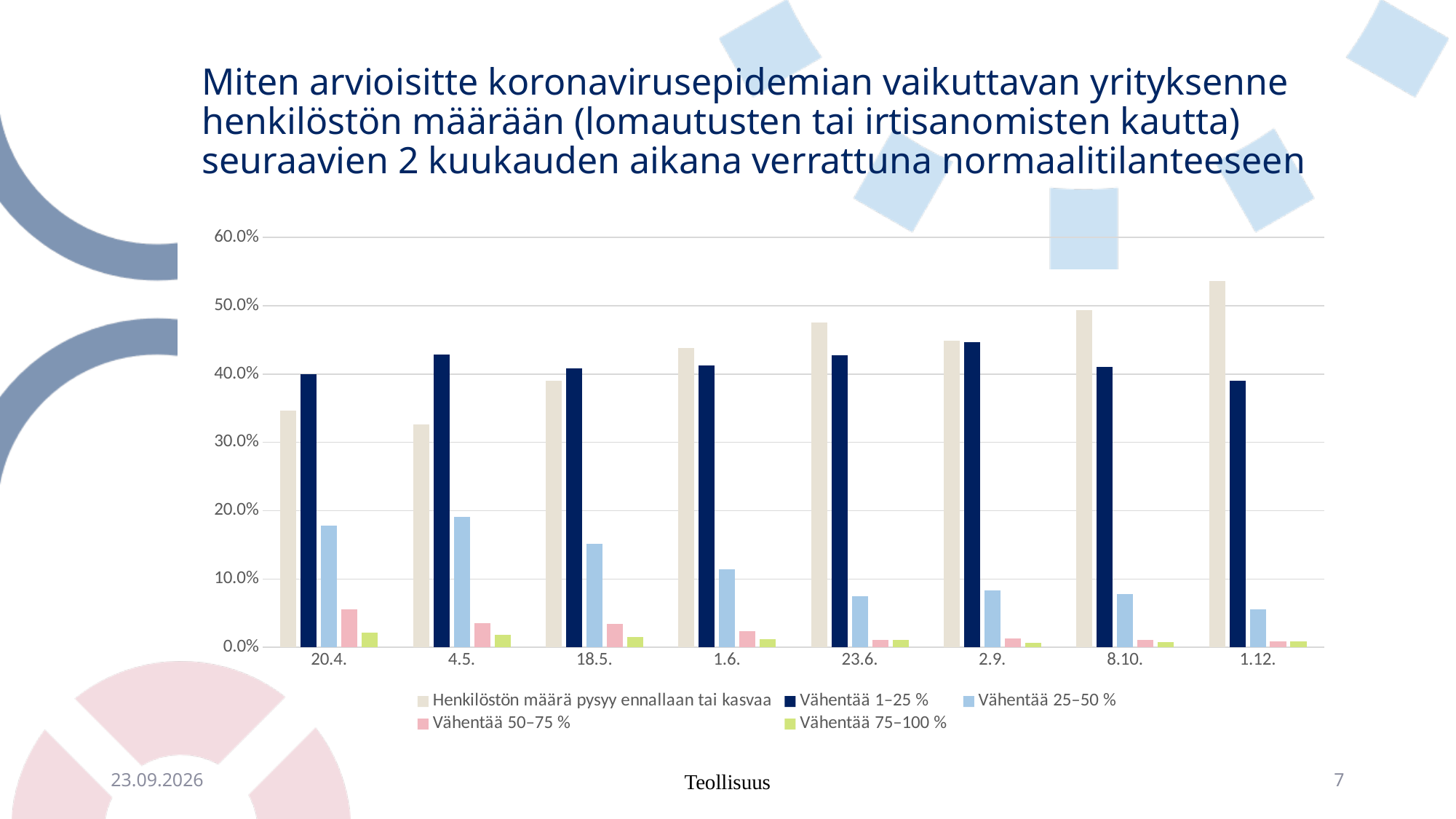
How many survey dates are shown along the x axis? 8 What kind of chart is shown on the slide? bar chart Is the value for 'Vähentää 25–50 %' on 20.4. greater or less than 20.0%? less Which series is shown in dark blue in the legend? Vähentää 1–25 % On 1.12., which is larger: 'Henkilöstön määrä pysyy ennallaan tai kasvaa' or 'Vähentää 1–25 %'? Henkilöstön määrä pysyy ennallaan tai kasvaa Is the value for 'Henkilöstön määrä pysyy ennallaan tai kasvaa' on 1.12. greater or less than 50.0%? greater On which date is the value for 'Henkilöstön määrä pysyy ennallaan tai kasvaa' highest? 1.12. Does the value for 'Vähentää 25–50 %' generally rise or fall from 20.4. to 1.12.? fall How many series does the legend list? 5 On which date is the value for 'Vähentää 25–50 %' highest? 4.5. On 20.4., which is larger: 'Vähentää 1–25 %' or 'Henkilöstön määrä pysyy ennallaan tai kasvaa'? Vähentää 1–25 % On which date is the value for 'Henkilöstön määrä pysyy ennallaan tai kasvaa' lowest? 4.5.